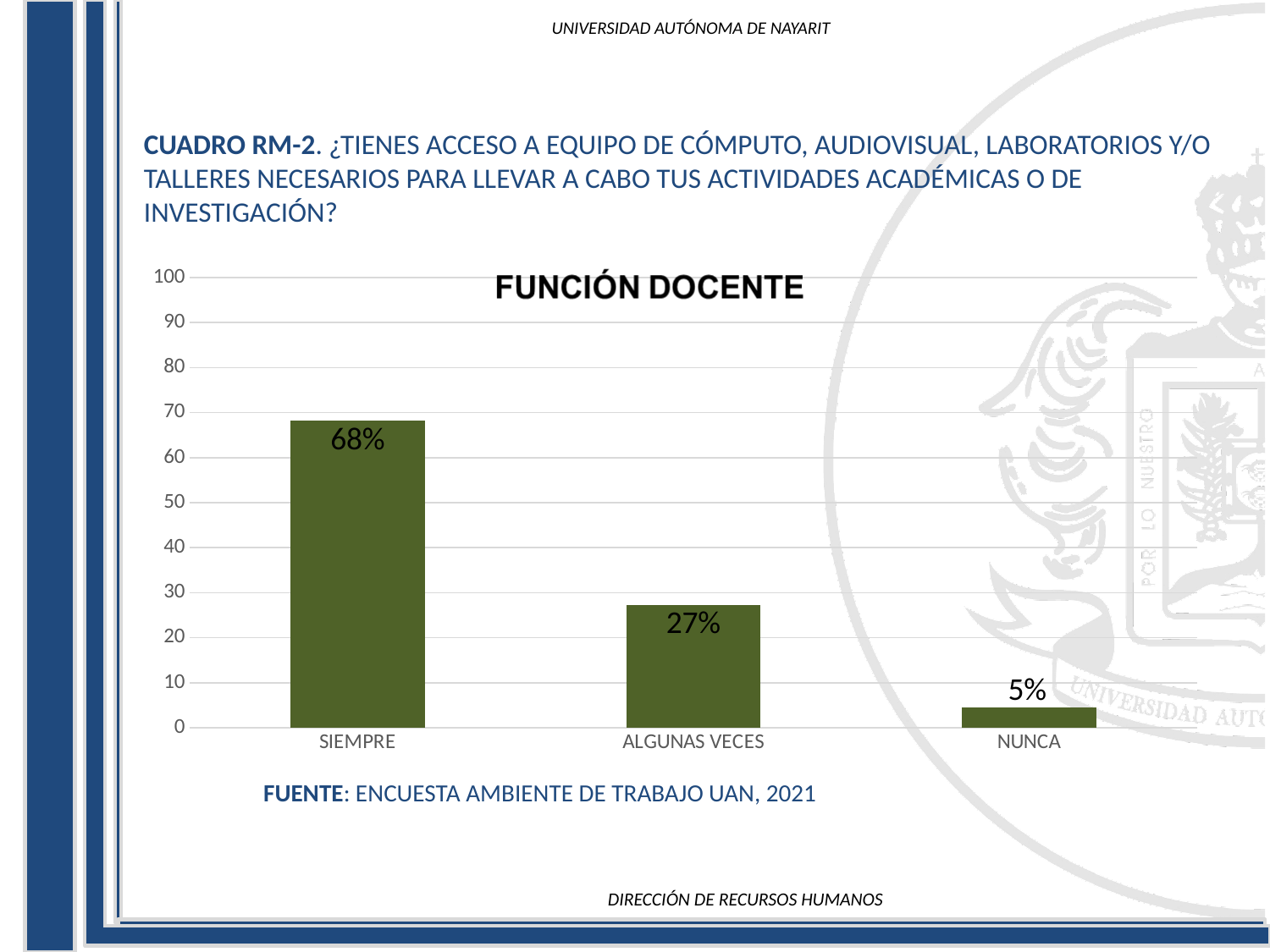
What kind of chart is shown on the slide? bar chart Is the value for SIEMPRE greater or less than 60? greater What is the value for NUNCA? 5% What is the difference between the values for SIEMPRE and ALGUNAS VECES? 41% What is the difference between the values for ALGUNAS VECES and NUNCA? 22% Which is larger, the value for ALGUNAS VECES or the value for NUNCA? ALGUNAS VECES Which category has the lowest value? NUNCA What is the title of the chart? FUNCIÓN DOCENTE What is the value for SIEMPRE? 68% Which category has the highest value? SIEMPRE What is the value for ALGUNAS VECES? 27% How many categories are shown on the x axis? 3